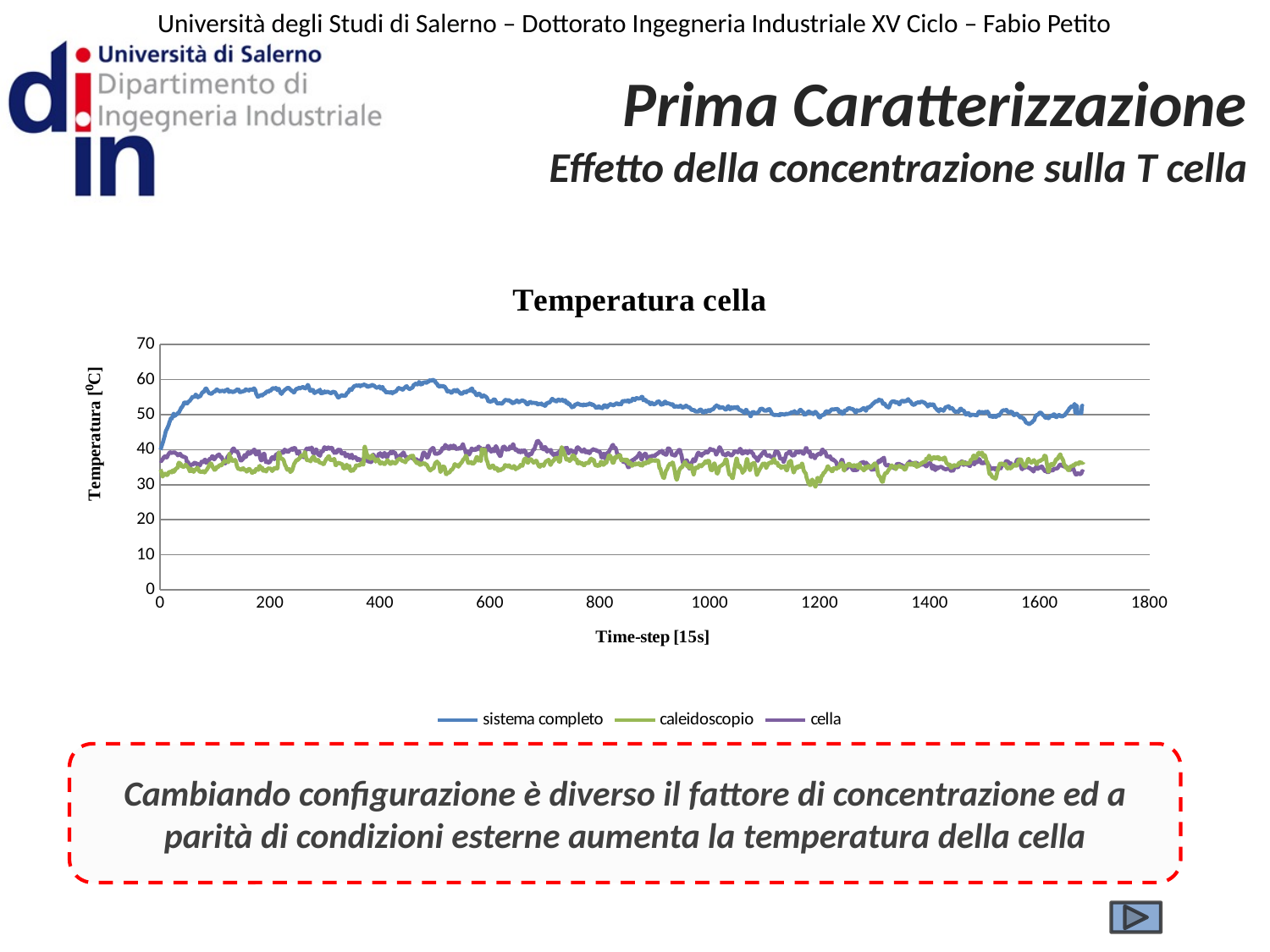
Is the value of the sistema completo series at time-step 1600 greater or less than 60? less What kind of chart is shown on the slide? line chart Is the value of the cella series at time-step 800 greater or less than 30? greater After its initial rise, does the sistema completo series generally rise or fall as the time-step increases from 500 to 1600? fall Which series has the highest temperature values throughout the chart? sistema completo How many series does the legend of the chart list? 3 What is the title of the chart? Temperatura cella What is the label of the x axis of the chart? Time-step [15s] Is the value of the caleidoscopio series at time-step 600 greater or less than 40? less At time-step 1000, which series has the larger value, sistema completo or caleidoscopio? sistema completo